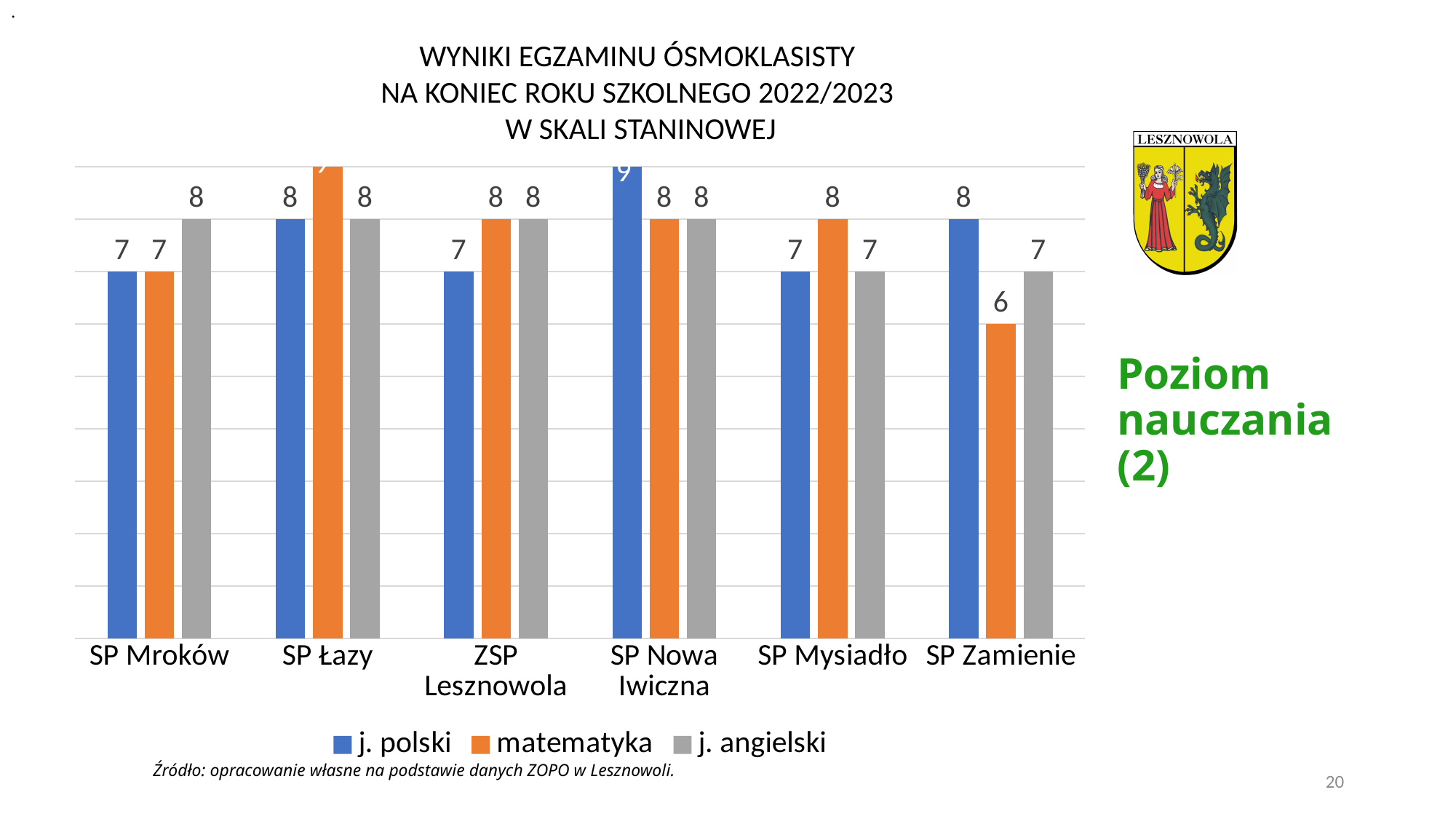
Which school has the lowest matematyka value? SP Zamienie What is the difference between the j. polski and matematyka values for SP Zamienie? 2 Which school has the highest j. polski value? SP Nowa Iwiczna What is the j. angielski value for SP Mroków? 8 Which colour represents matematyka in the legend? orange What is the matematyka value for SP Łazy? 9 Which is larger for SP Mysiadło: the matematyka value or the j. angielski value? matematyka What is the j. polski value for SP Nowa Iwiczna? 9 What is the matematyka value for SP Zamienie? 6 How many series does the legend list? 3 What kind of chart is shown on the slide? bar chart How many schools are shown on the x axis? 6